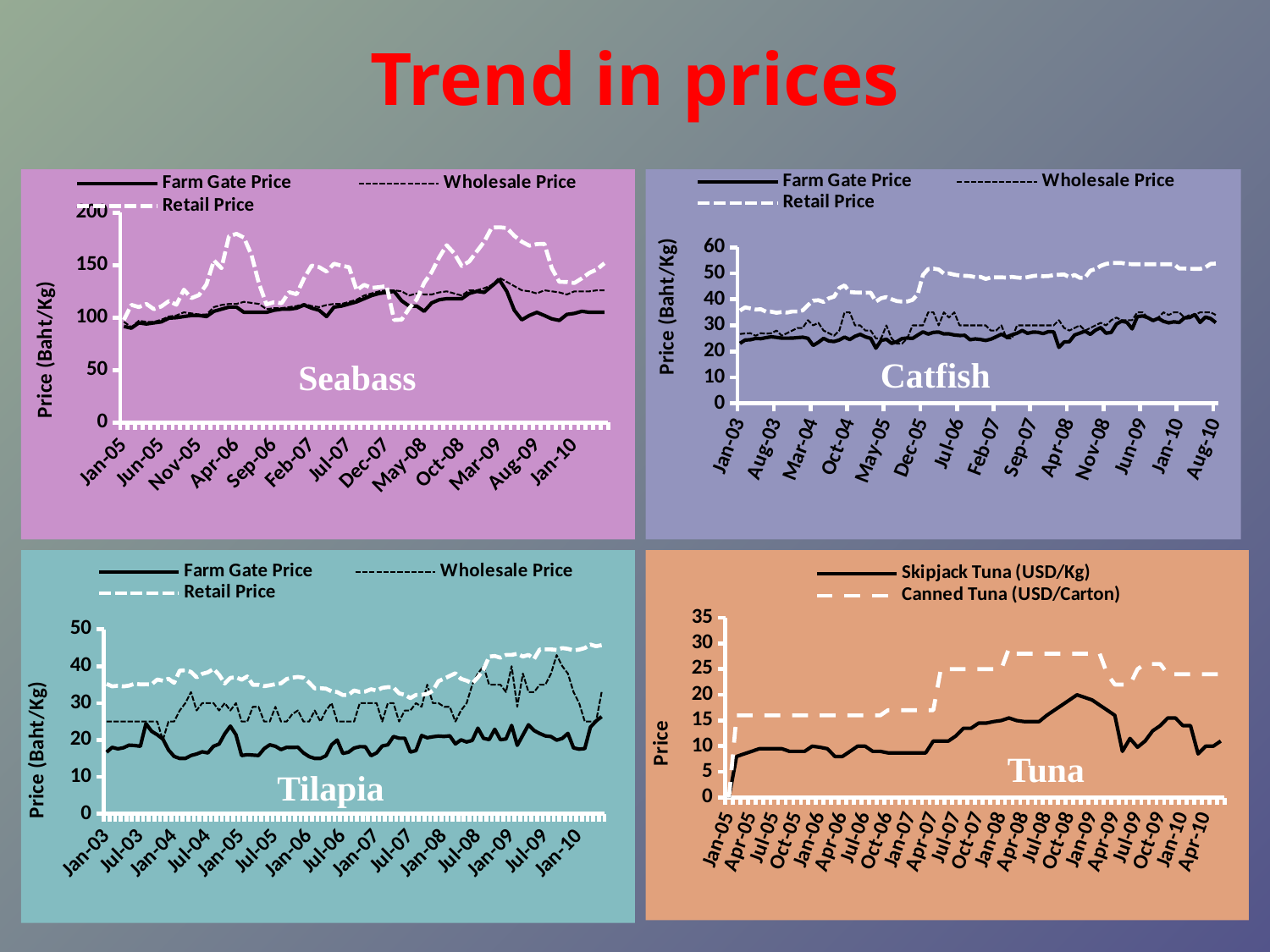
In the Catfish chart, does the Retail Price overall rise or fall from Jan-03 to Aug-10? rise What kind of chart is the Seabass chart? line chart In the Catfish chart, is the Retail Price at Jul-06 greater or less than 40? greater In the Catfish chart, is the Farm Gate Price at Jan-03 greater or less than 30? less In the Tuna chart, does the Canned Tuna series overall rise or fall from Jan-05 to Apr-10? rise In the Seabass chart, is the Retail Price at Mar-09 greater or less than 150? greater How many series does the legend of the Tuna chart list? 2 How many series does the legend of the Catfish chart list? 3 What is the y-axis label of the Tilapia chart? Price (Baht/Kg)